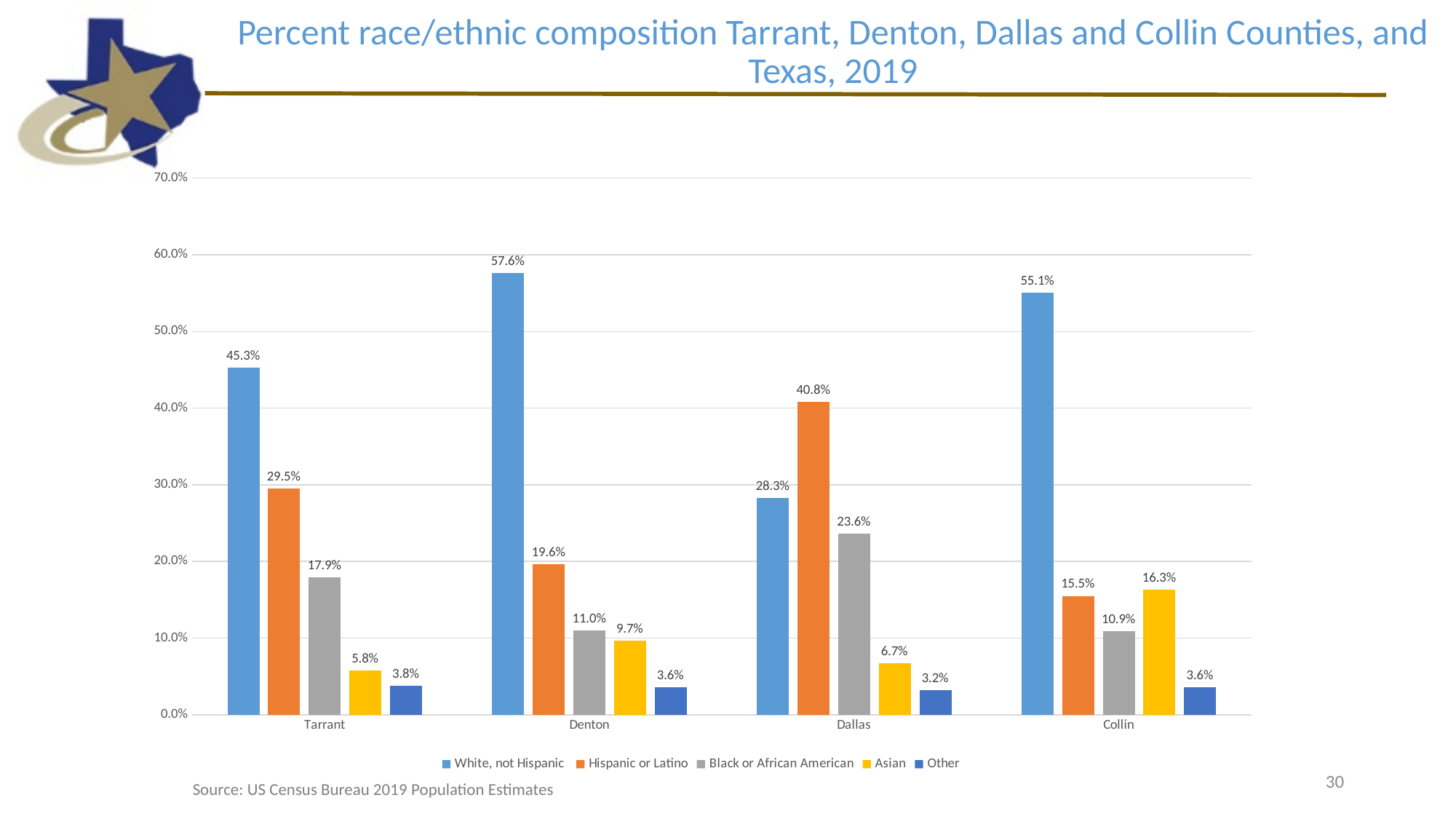
What is the value for White, not Hispanic in Denton? 57.6% What is the difference between the Hispanic or Latino values for Tarrant and Denton? 9.9% Which county has the highest value for White, not Hispanic? Denton Which county has the lowest value for Other? Dallas What kind of chart is shown on the slide? Bar chart Which is larger in Dallas: White, not Hispanic or Hispanic or Latino? Hispanic or Latino How many series does the legend list? 5 What is the source cited below the chart? US Census Bureau 2019 Population Estimates What is the value for Black or African American in Tarrant? 17.9% What is the value for Asian in Collin? 16.3% What is the value for Hispanic or Latino in Dallas? 40.8% How many counties are shown on the x axis? 4